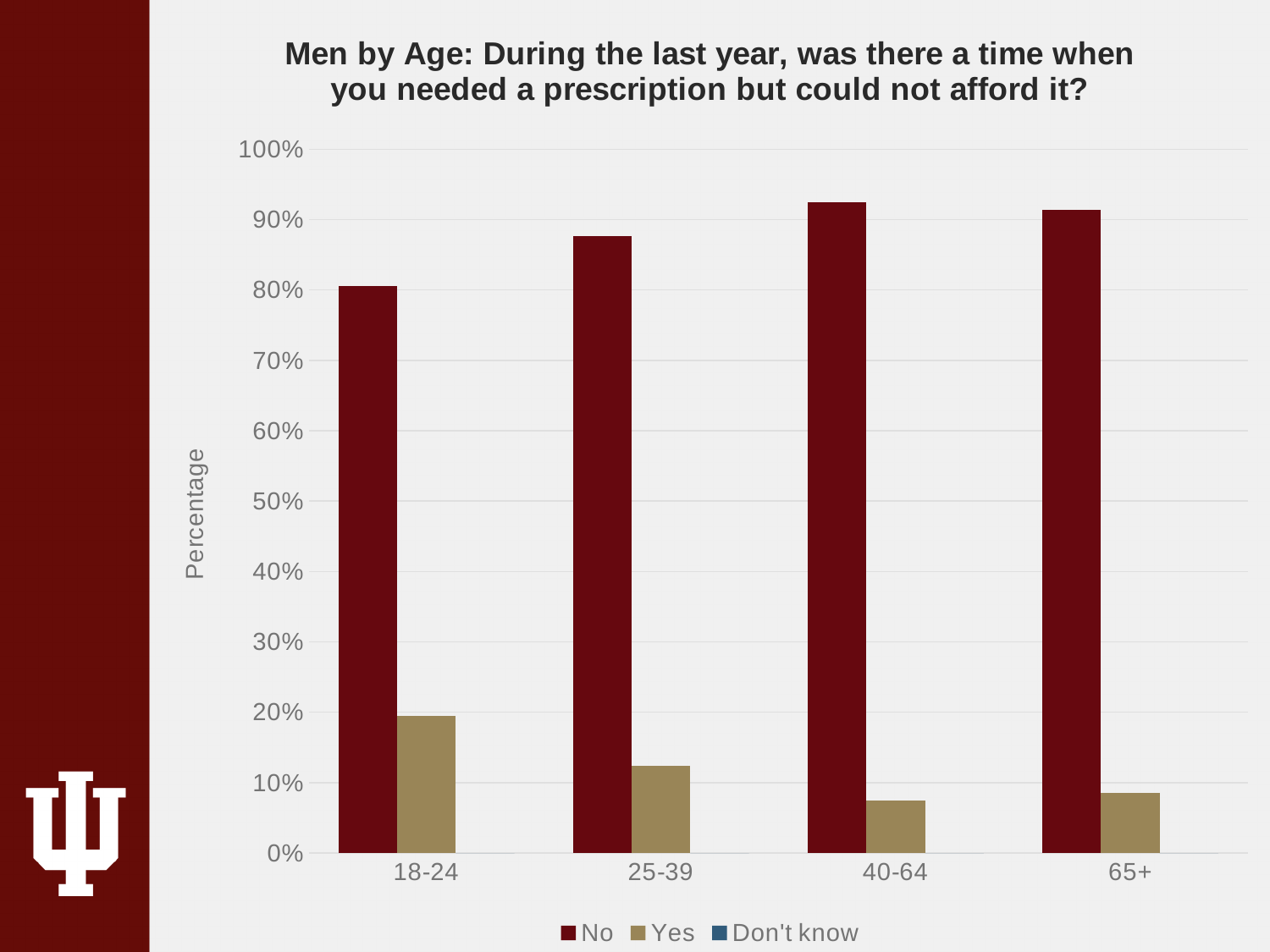
What kind of chart is shown on the slide? bar chart Does the No series rise or fall from 18-24 to 40-64? rise How many age groups are shown on the x axis? 4 Is the Yes value for 25-39 greater or less than 10%? greater What is the label on the vertical axis? Percentage How many series does the legend list? 3 Which age group has the lowest value for the No series? 18-24 Is the Yes value for 40-64 greater or less than 10%? less Is the No value for 25-39 greater or less than 90%? less Which is larger, the No value for 18-24 or the No value for 25-39? 25-39 Which age group has the highest value for the Yes series? 18-24